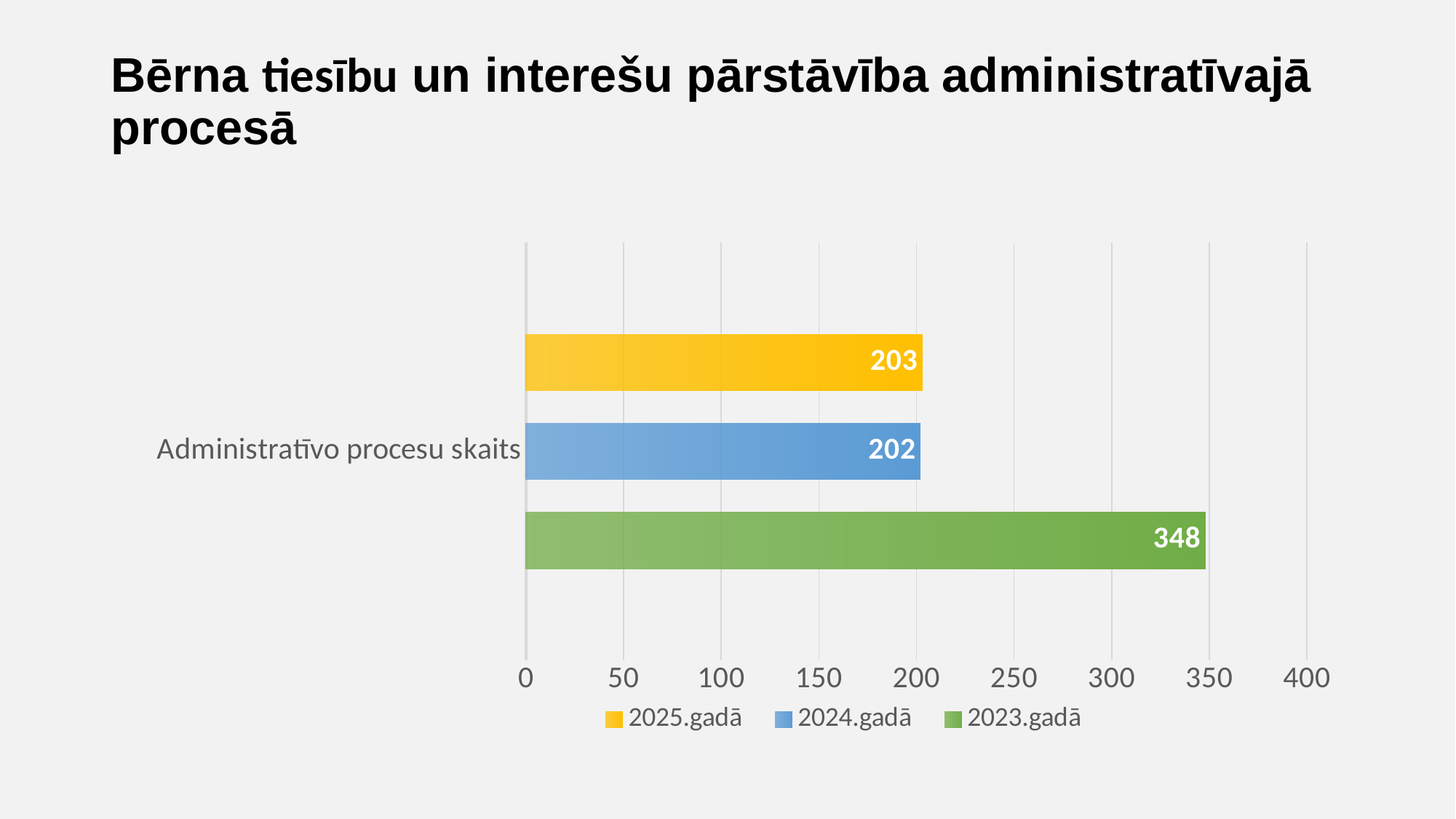
What is the value for 2024.gadā for Administratīvo procesu skaits? 202 What is the value for 2023.gadā for Administratīvo procesu skaits? 348 What is the difference between the 2023.gadā and 2025.gadā values? 145 What is the value for 2025.gadā for Administratīvo procesu skaits? 203 Is the value for 2023.gadā greater or less than 300? greater How many series does the legend list? 3 What colour is the bar for 2023.gadā? Green Is the value for 2024.gadā greater or less than 250? less Which year has the highest value for Administratīvo procesu skaits? 2023.gadā Which is larger, the value for 2023.gadā or the value for 2024.gadā? 2023.gadā What kind of chart is shown on the slide? Bar chart What is the difference between the 2023.gadā and 2024.gadā values? 146